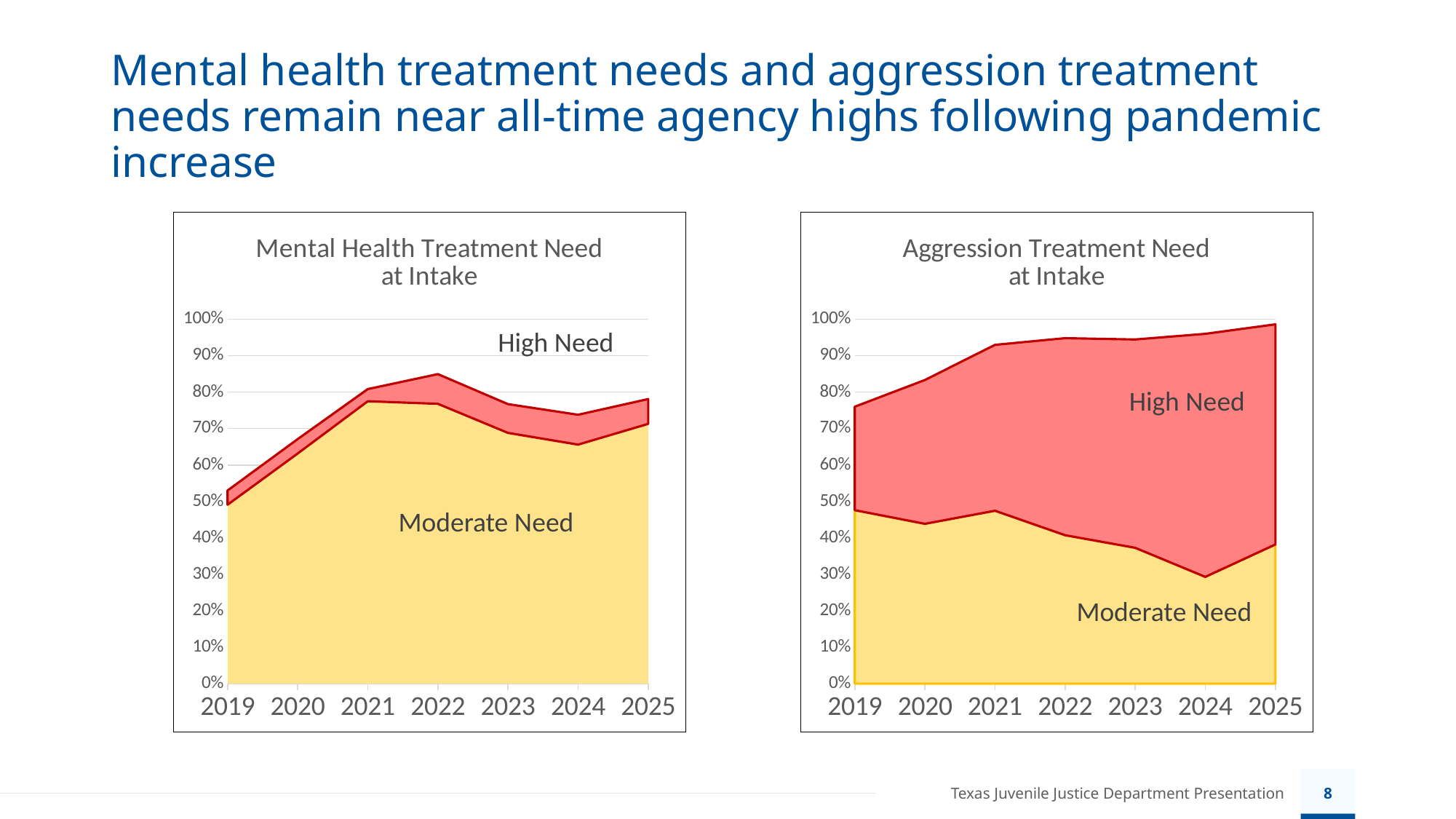
In the Aggression Treatment Need at Intake chart, which year has the highest combined Moderate and High Need total? 2025 What kind of chart is the Mental Health Treatment Need at Intake chart? area chart In the Aggression Treatment Need at Intake chart, is the Moderate Need value for 2024 greater or less than 40%? less In the Aggression Treatment Need at Intake chart, is the combined Moderate and High Need total for 2025 greater or less than 90%? greater How many need categories are plotted in the Mental Health Treatment Need at Intake chart? 2 In the Aggression Treatment Need at Intake chart, which year has the lowest Moderate Need value? 2024 In the Aggression Treatment Need at Intake chart, does the Moderate Need value rise or fall from 2021 to 2024? fall In the Mental Health Treatment Need at Intake chart, is the Moderate Need value for 2019 greater or less than 60%? less In the Mental Health Treatment Need at Intake chart, what colour is the High Need area? red In the Mental Health Treatment Need at Intake chart, which year has the highest combined Moderate and High Need total? 2022 How many years are shown on the x axis of the Aggression Treatment Need at Intake chart? 7